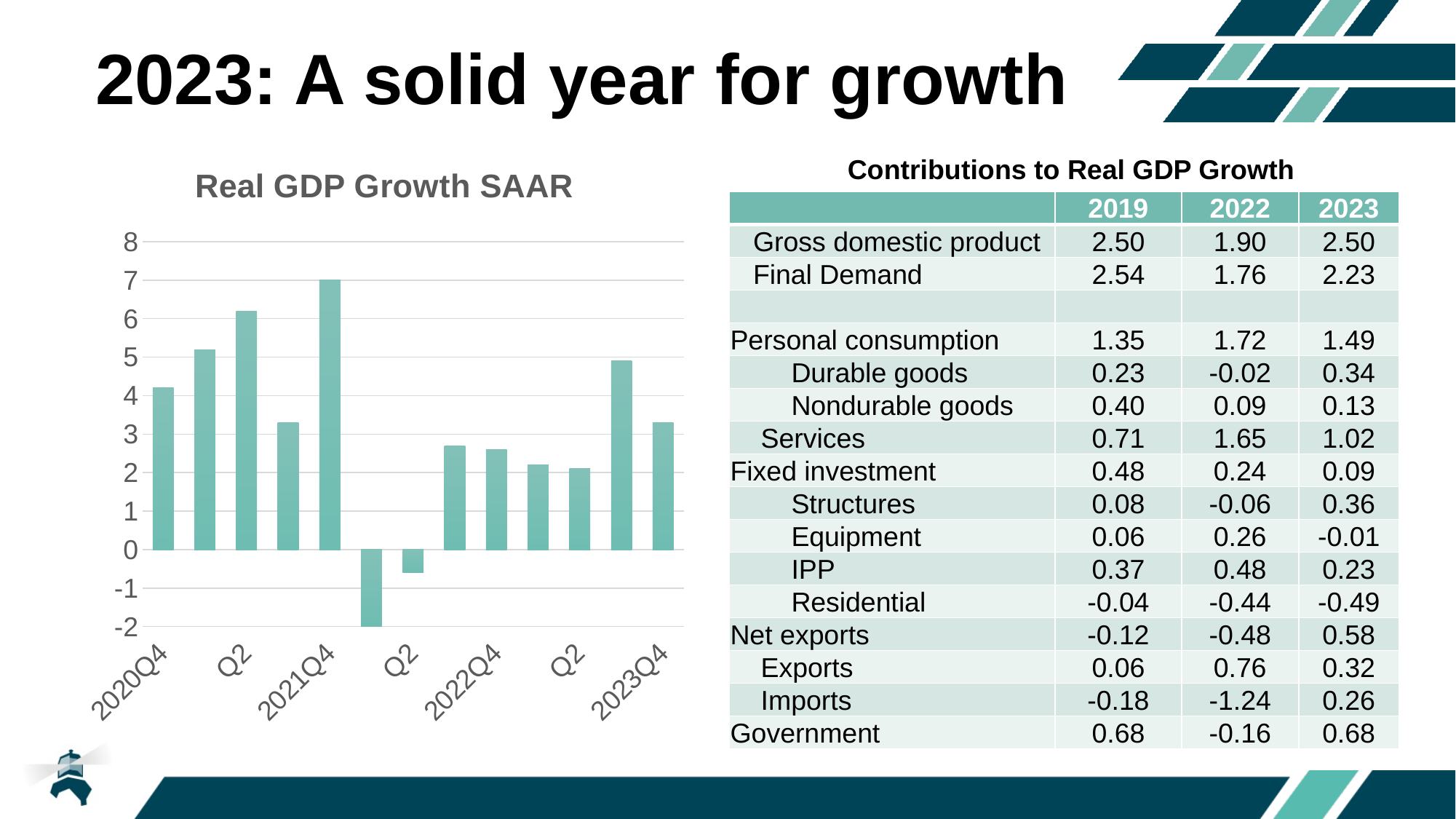
Is the value for 2021Q4 in the Real GDP Growth SAAR chart greater or less than 6? greater What is the title of the bar chart on the slide? Real GDP Growth SAAR Which is larger in the Real GDP Growth SAAR chart, the value for 2021Q4 or the value for 2023Q4? 2021Q4 How many bars in the Real GDP Growth SAAR chart are negative? 2 What kind of chart is the Real GDP Growth SAAR chart? bar chart Which labelled quarter has the highest bar in the Real GDP Growth SAAR chart? 2021Q4 Is the value for 2023Q4 in the Real GDP Growth SAAR chart greater or less than 3? greater How many bars are plotted in the Real GDP Growth SAAR chart? 13 Is the value for 2020Q4 in the Real GDP Growth SAAR chart greater or less than 5? less What is the highest value shown on the vertical axis of the Real GDP Growth SAAR chart? 8 Which is larger in the Real GDP Growth SAAR chart, the value for 2020Q4 or the value for 2022Q4? 2020Q4